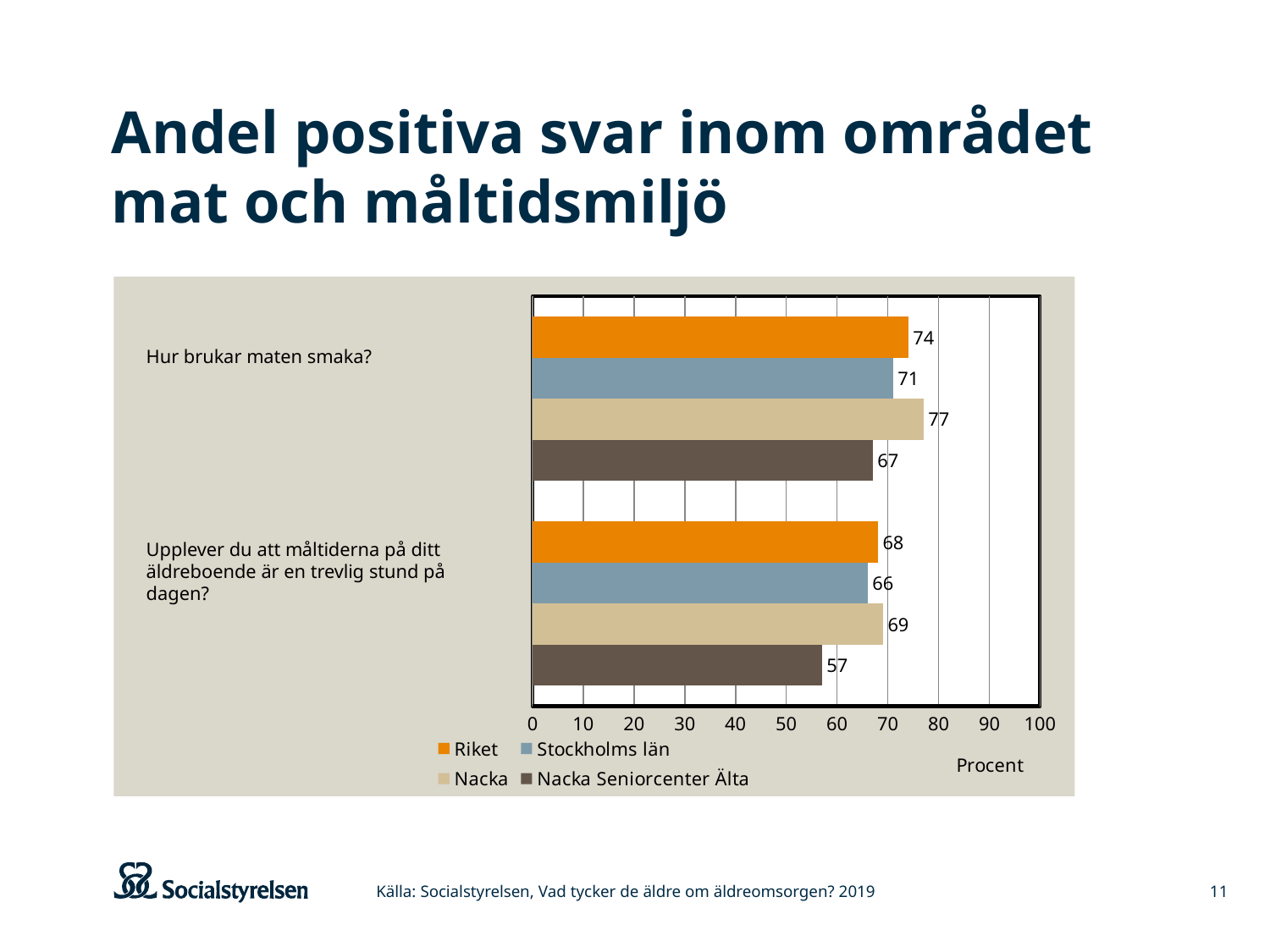
What is the value for Riket for the question "Hur brukar maten smaka?"? 74 What is the value for Nacka for the question "Hur brukar maten smaka?"? 77 How many question categories are shown on the chart? 2 What is the value for Stockholms län for the question "Upplever du att måltiderna på ditt äldreboende är en trevlig stund på dagen?"? 66 What is the value for Nacka Seniorcenter Älta for the question "Upplever du att måltiderna på ditt äldreboende är en trevlig stund på dagen?"? 57 What kind of chart is shown on the slide? Bar chart Which is larger for the question "Upplever du att måltiderna på ditt äldreboende är en trevlig stund på dagen?": Riket or Nacka? Nacka How many series does the legend list? 4 Which series has the lowest value for the question "Upplever du att måltiderna på ditt äldreboende är en trevlig stund på dagen?"? Nacka Seniorcenter Älta Which series has the highest value for the question "Hur brukar maten smaka?"? Nacka What is the label of the x axis? Procent What is the difference between the Nacka and Nacka Seniorcenter Älta values for the question "Hur brukar maten smaka?"? 10